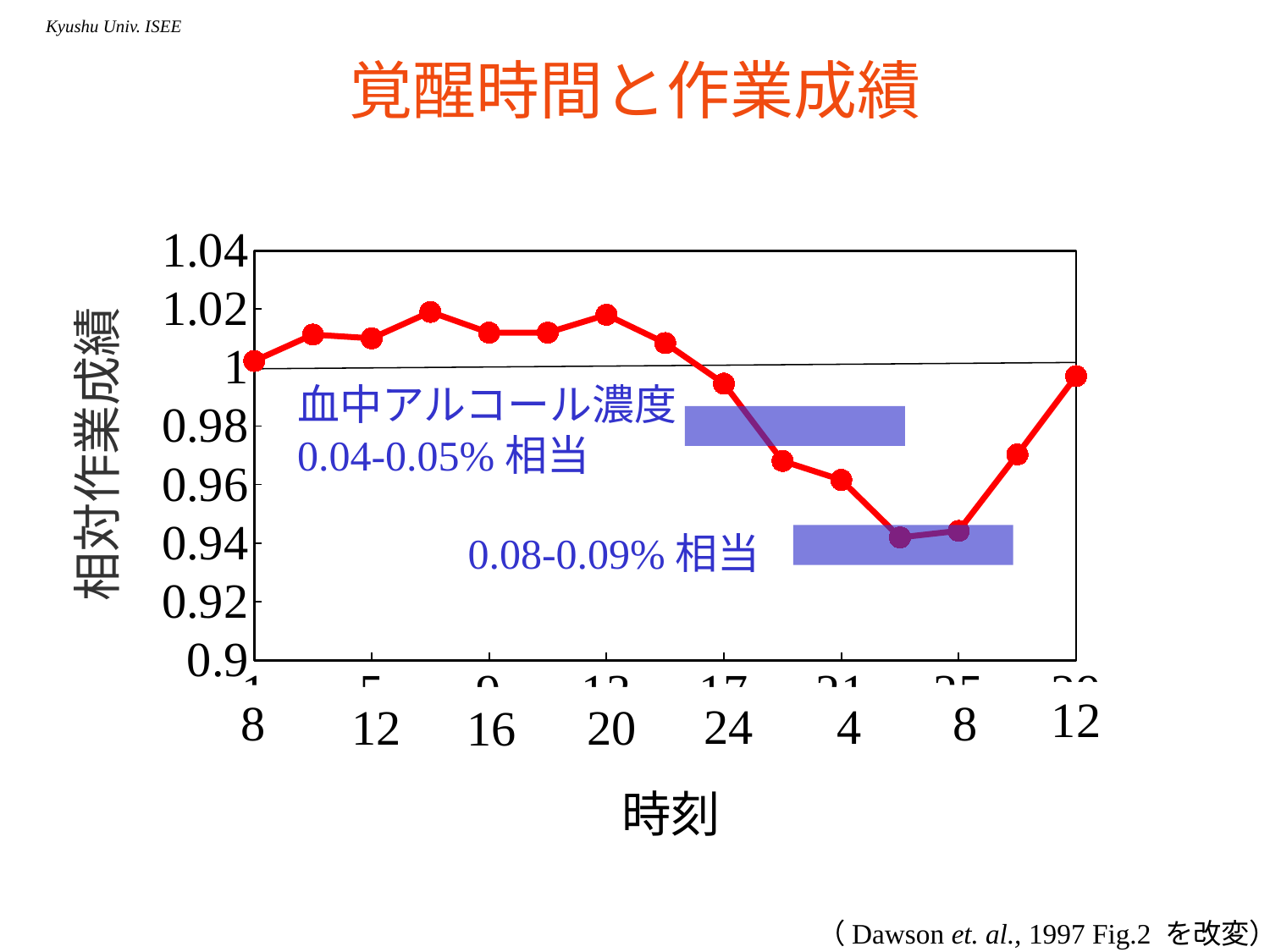
What kind of chart is shown on the slide? line chart Do the values rise or fall between 時刻 20 and 時刻 4? fall Which has the larger value, 時刻 20 or 時刻 4? 時刻 20 What is the title of the chart on the slide? 覚醒時間と作業成績 What is the label of the vertical axis? 相対作業成績 Do the values rise or fall between the second 時刻 8 and the final 時刻 12 on the right? rise Is the lowest point on the line above or below 0.95? below Is the value at 時刻 4 greater or less than 0.98? less Is the value at the second 時刻 8 (on the right side of the axis) greater or less than 0.96? less How many data points are plotted on the red line? 15